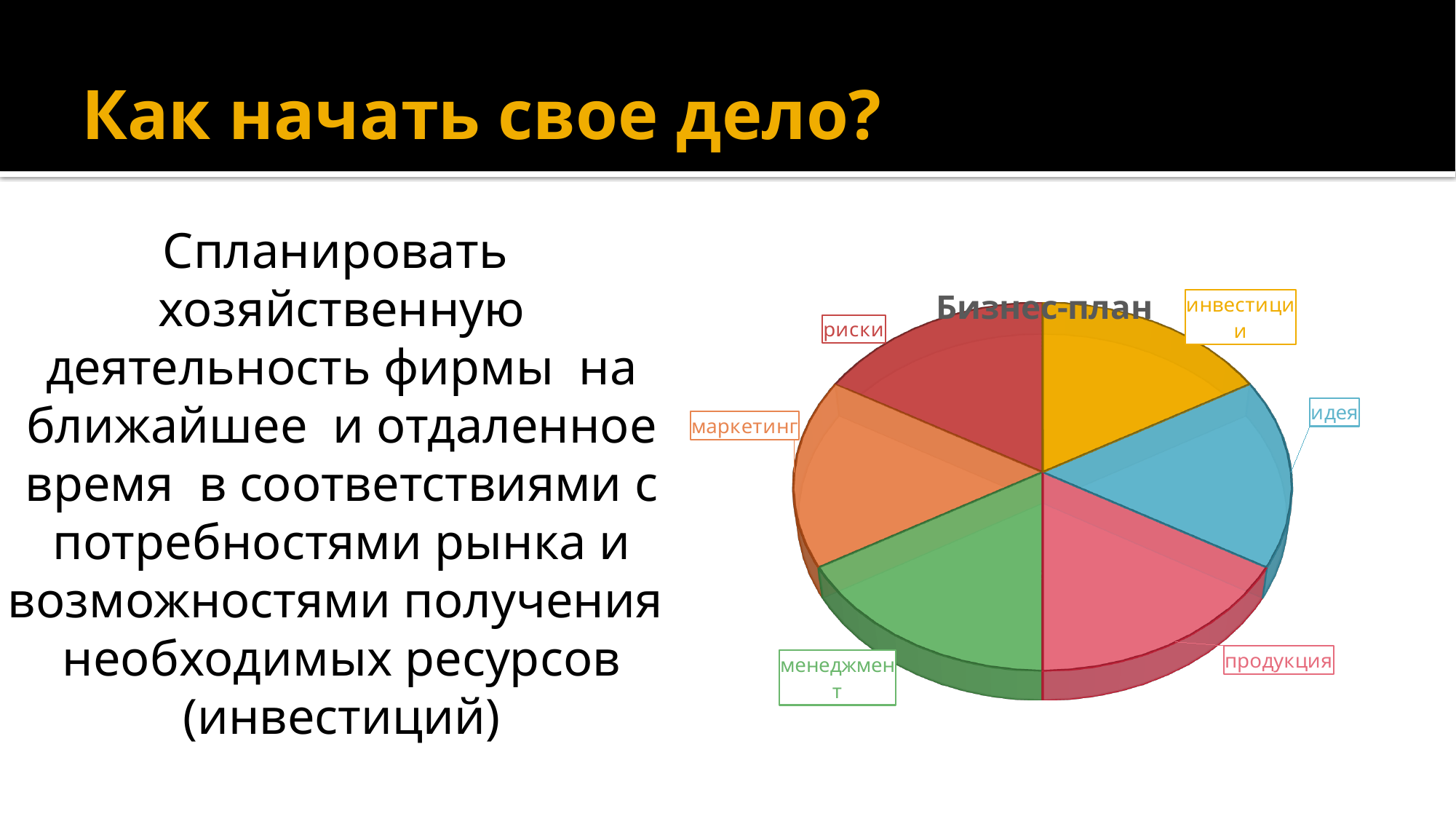
How many slices does the pie chart have? 6 Which slice of the pie chart is coloured orange? маркетинг What kind of chart is shown on the slide? pie chart Which slice of the pie chart is coloured green? менеджмент Which slice of the pie chart is coloured pink? продукция Which slice of the pie chart is labelled in blue? идея Which slice of the pie chart is coloured dark red? риски Does the pie chart show any numeric data labels on its slices? No Which slice of the pie chart is coloured yellow? инвестиции What is the title of the pie chart? Бизнес-план